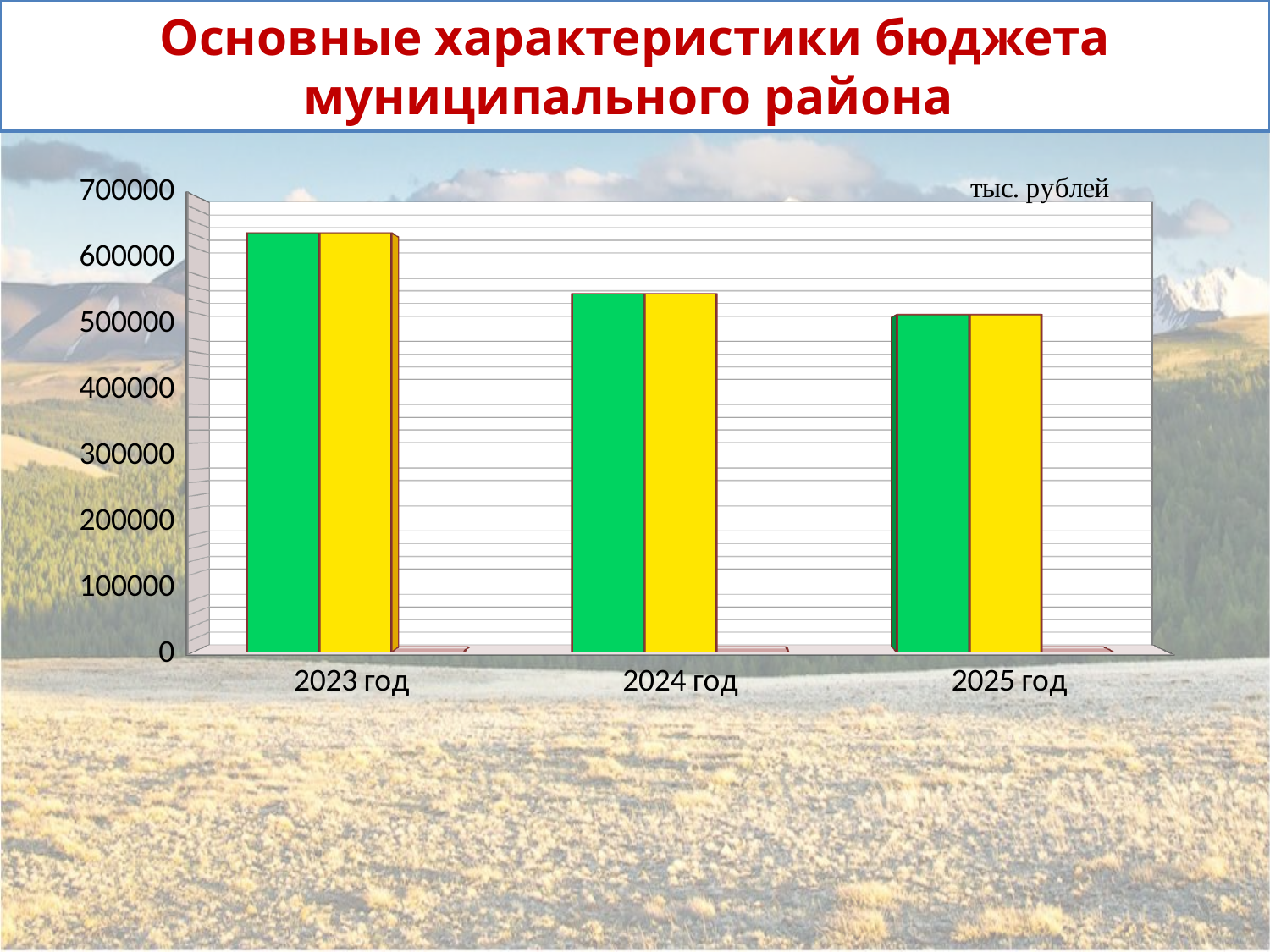
What kind of chart is shown on the slide? bar chart Which year has the tallest green bar? 2023 год How many year categories are shown on the x axis of the chart? 3 Do the green bars rise or fall from 2023 год to 2025 год? fall Is the green bar for 2023 год greater or less than 600000? greater What is the highest value shown on the vertical axis of the chart? 700000 Is the yellow bar for 2024 год greater or less than 600000? less Which year has the shortest yellow bar? 2025 год Which is larger, the green bar for 2023 год or the green bar for 2024 год? 2023 год Is the green bar for 2024 год greater or less than 500000? greater What unit of measurement is written in the top right corner of the chart? тыс. рублей